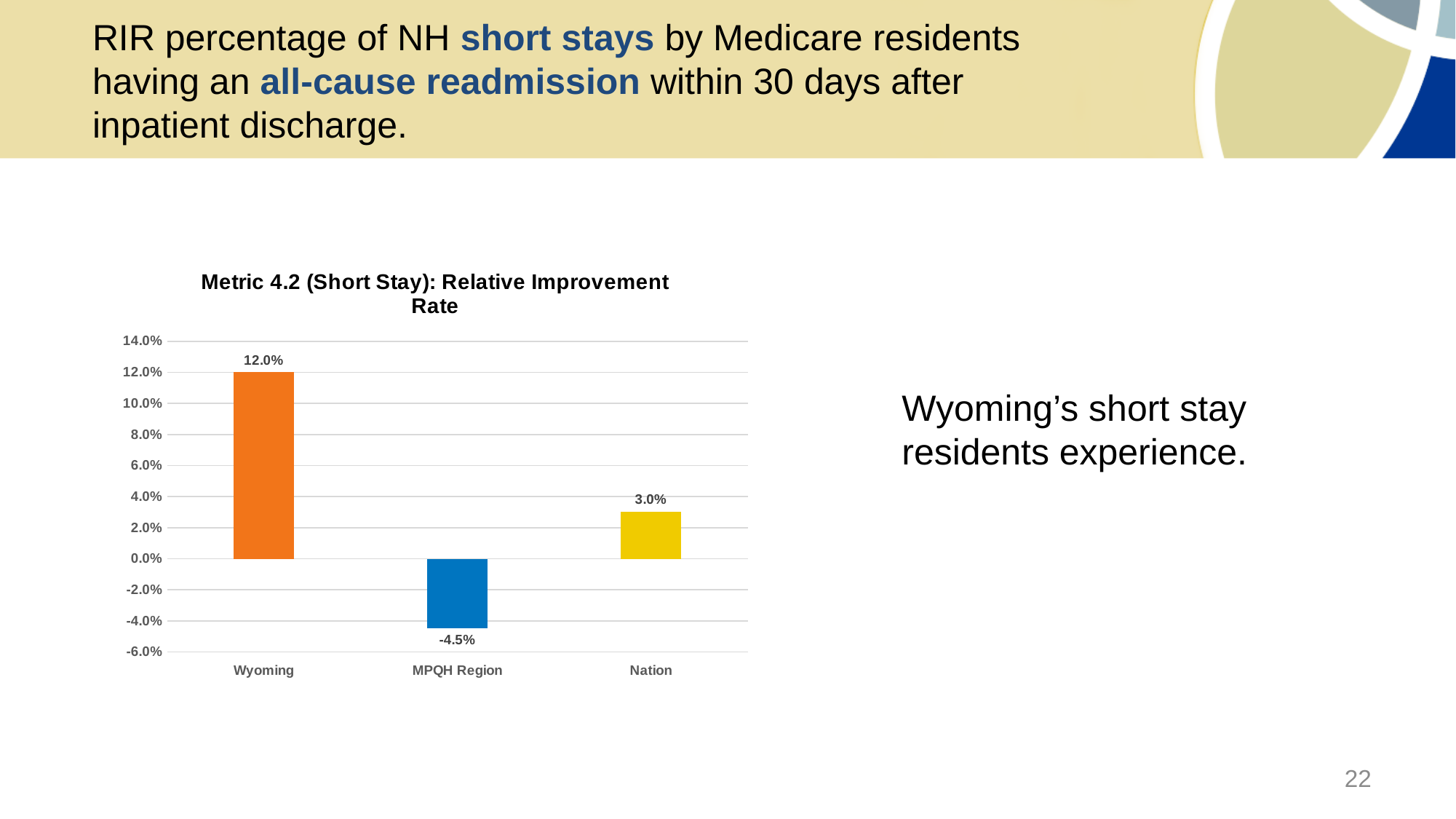
Which is larger, the value for Nation or the value for MPQH Region? Nation What is the value for Nation? 3.0% Is the value for Wyoming greater or less than 10.0%? greater Which category has the highest value? Wyoming What kind of chart is shown on the slide? bar chart What is the value for MPQH Region? -4.5% Which category has the lowest value? MPQH Region What is the value for Wyoming? 12.0% What is the difference between the values for Nation and MPQH Region? 7.5% How many categories are shown on the x axis? 3 What is the title of the chart? Metric 4.2 (Short Stay): Relative Improvement Rate What is the difference between the values for Wyoming and Nation? 9.0%